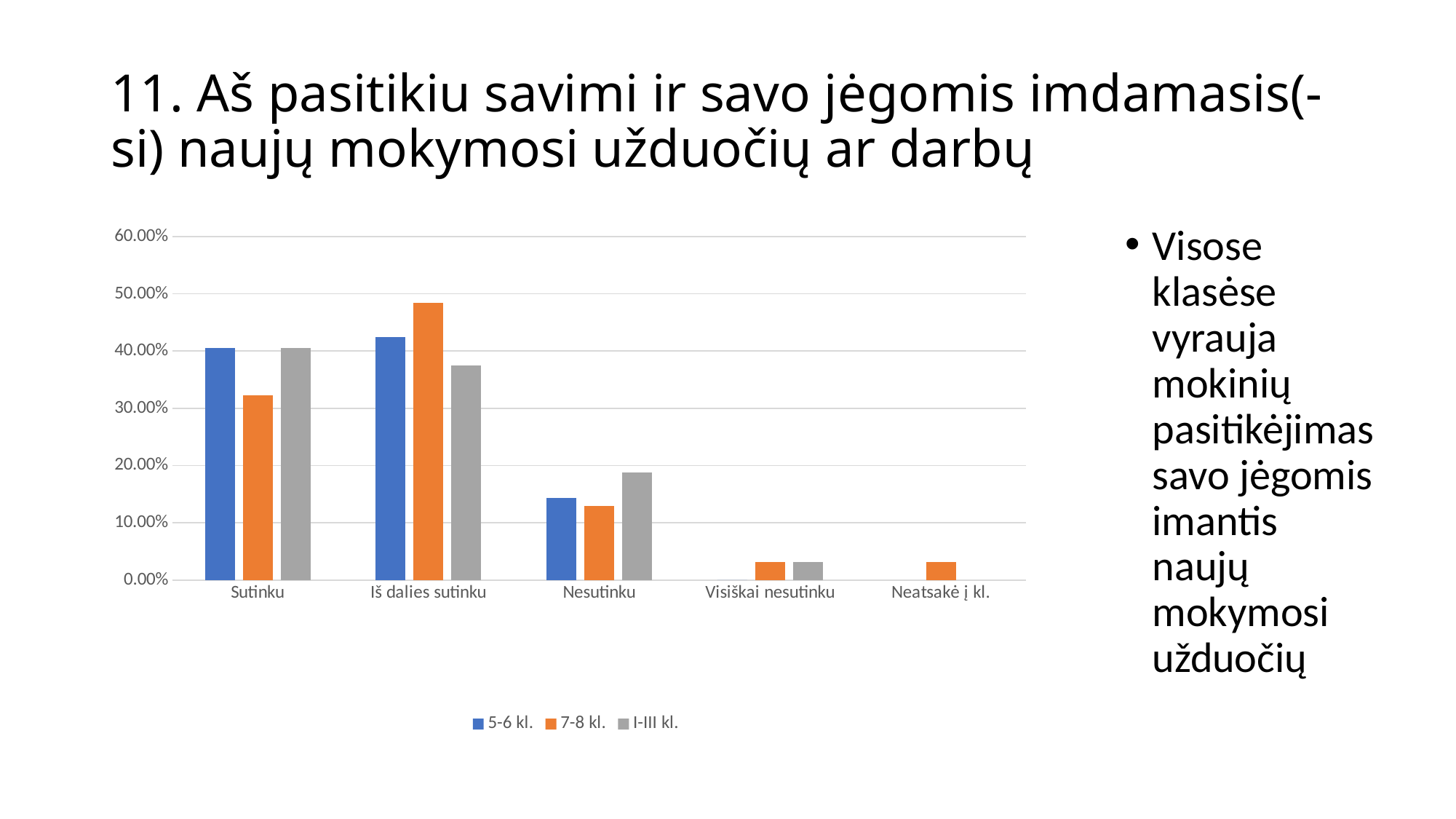
How many categories are shown on the x axis of the chart? 5 Which colour represents the 7-8 kl. series in the chart? orange What kind of chart is shown on the slide? bar chart Is the value for I-III kl. in the Nesutinku category greater or less than 10.00%? greater In the Sutinku category, which series has the larger value: 5-6 kl. or 7-8 kl.? 5-6 kl. Is the value for 7-8 kl. in the Iš dalies sutinku category greater or less than 50.00%? less Which category has the highest value for the I-III kl. series? Sutinku In the Nesutinku category, which series has the larger value: 5-6 kl. or I-III kl.? I-III kl. How many series does the chart legend list? 3 Which series has the tallest bar in the whole chart? 7-8 kl. Which category has the highest value for the 7-8 kl. series? Iš dalies sutinku Is the value for 7-8 kl. in the Sutinku category greater or less than 30.00%? greater